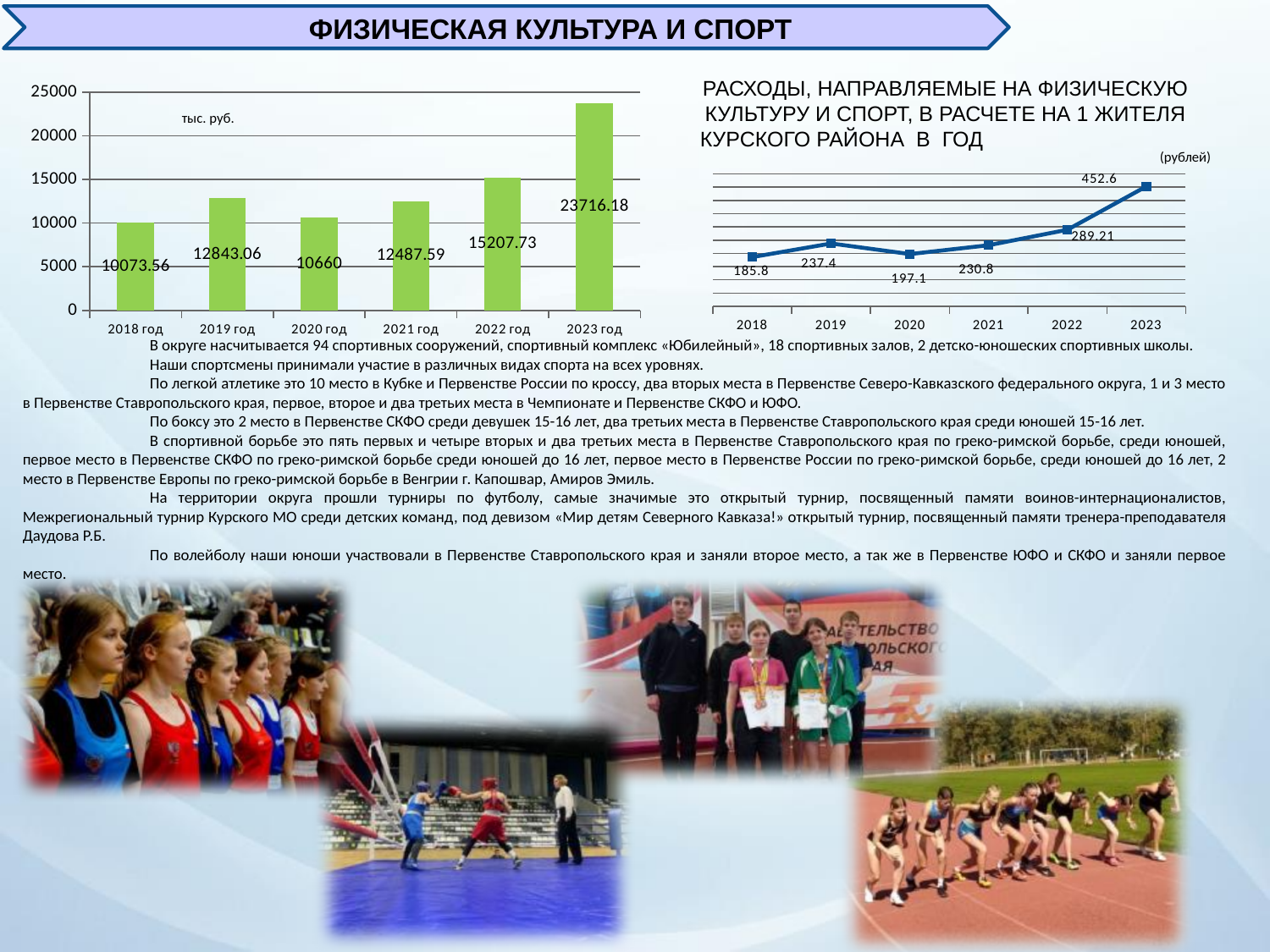
On the left bar chart (тыс. руб.), which year has the highest value? 2023 год On the left bar chart (тыс. руб.), which year has the lowest value? 2018 год On the left bar chart (тыс. руб.), which is larger: the value for 2019 год or 2021 год? 2019 год On the right line chart (расходы на 1 жителя, рублей), which year has the lowest value? 2018 What kind of chart is the right chart (расходы на 1 жителя, рублей)? line chart On the right line chart (расходы на 1 жителя, рублей), what is the difference between the values for 2023 and 2022? 163.39 What kind of chart is the left chart (тыс. руб.)? bar chart On the left bar chart (тыс. руб.), what is the difference between the values for 2023 год and 2022 год? 8508.45 On the left bar chart (тыс. руб.), what is the value for 2023 год? 23716.18 On the left bar chart (тыс. руб.), what is the value for 2020 год? 10660 On the right line chart (расходы на 1 жителя, рублей), what is the value for 2022? 289.21 On the left bar chart (тыс. руб.), how many years are shown? 6